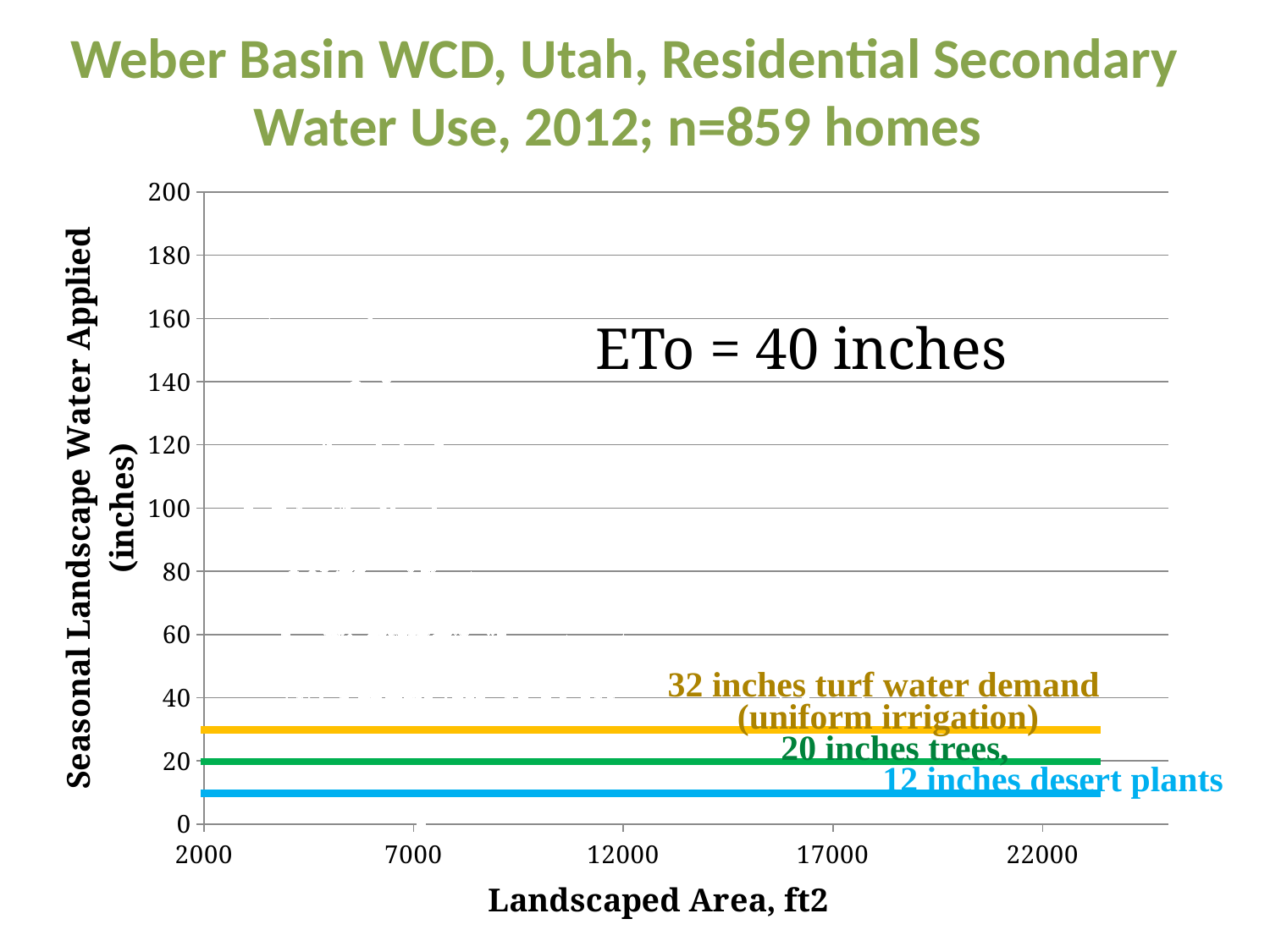
Which reference line is the lowest on the chart: turf water demand, trees, or desert plants? desert plants What ETo value is annotated on the chart? ETo = 40 inches Is the yellow turf water demand line greater or less than 40 on the y axis? less Which line is higher on the chart, the green trees line or the blue desert plants line? green trees line Do the reference lines rise, fall, or stay flat as landscaped area increases along the x axis? stay flat Is the yellow turf water demand line greater or less than 20 on the y axis? greater What kind of chart is shown on the slide? scatter plot Is the blue desert plants line greater or less than 20 on the y axis? less How many horizontal reference lines are drawn on the chart? 3 What is the title of the chart on the slide? Weber Basin WCD, Utah, Residential Secondary Water Use, 2012; n=859 homes Which reference line is the highest on the chart: turf water demand, trees, or desert plants? turf water demand What is the maximum value shown on the y axis? 200